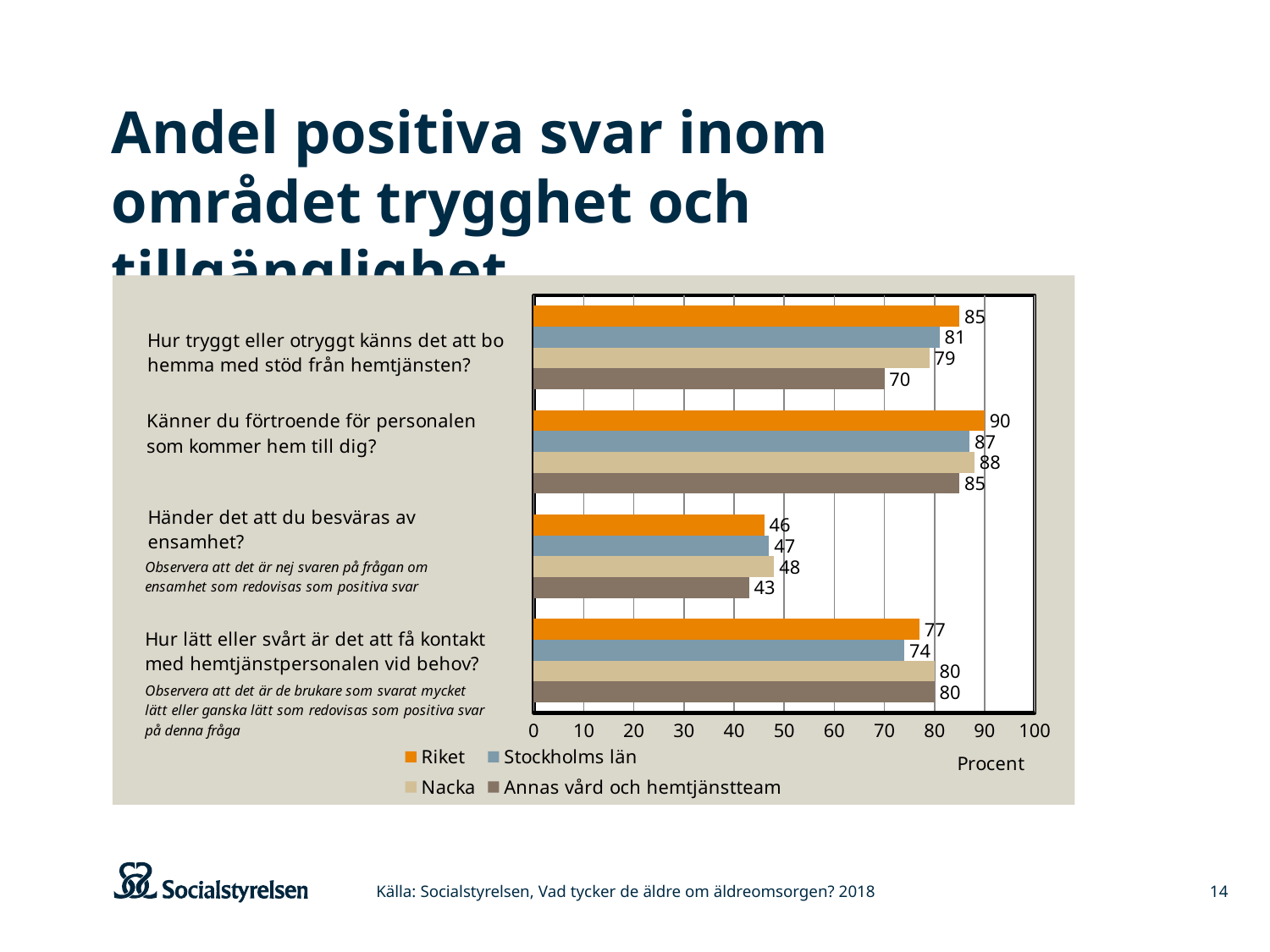
What is the value for Stockholms län on the question "Hur lätt eller svårt är det att få kontakt med hemtjänstpersonalen vid behov?" 74 What is the difference between Riket and Annas vård och hemtjänstteam on the question "Hur tryggt eller otryggt känns det att bo hemma med stöd från hemtjänsten?" 15 What is the value for Annas vård och hemtjänstteam on the question "Hur tryggt eller otryggt känns det att bo hemma med stöd från hemtjänsten?" 70 How many series does the legend list? 4 What label is shown on the horizontal axis of the chart? Procent Which is larger on the question "Hur lätt eller svårt är det att få kontakt med hemtjänstpersonalen vid behov?": Riket or Nacka? Nacka What is the value for Nacka on the question "Händer det att du besväras av ensamhet?" 48 How many question categories are shown on the chart? 4 What is the value for Riket on the question "Känner du förtroende för personalen som kommer hem till dig?" 90 What kind of chart is shown on the slide? Bar chart Which series has the highest value on the question "Hur tryggt eller otryggt känns det att bo hemma med stöd från hemtjänsten?" Riket Which series has the lowest value on the question "Händer det att du besväras av ensamhet?" Annas vård och hemtjänstteam